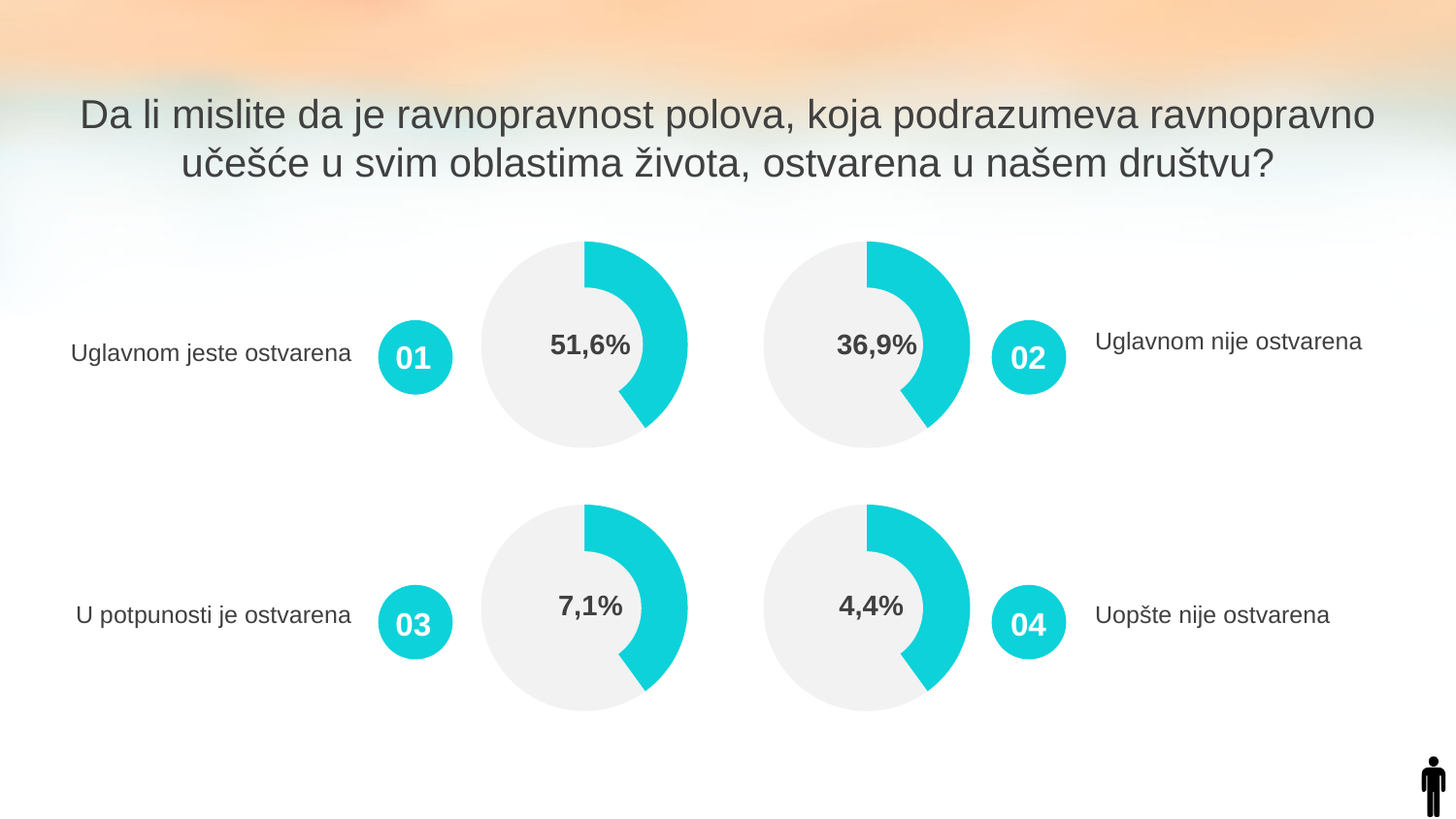
What percentage is shown for "Uglavnom jeste ostvarena"? 51,6% What percentage is shown for "Uglavnom nije ostvarena"? 36,9% Which number label is next to the chart for "Uopšte nije ostvarena"? 04 Which response option has the lowest percentage? Uopšte nije ostvarena What is the difference in percentage points between "Uglavnom jeste ostvarena" and "Uglavnom nije ostvarena"? 14,7 Which response option has the highest percentage? Uglavnom jeste ostvarena How many response options are shown on the slide? 4 What percentage is shown for "Uopšte nije ostvarena"? 4,4% What kind of chart is used to display each percentage on the slide? Donut (pie) chart What percentage is shown for "U potpunosti je ostvarena"? 7,1% What is the difference in percentage points between "U potpunosti je ostvarena" and "Uopšte nije ostvarena"? 2,7 Which is larger, the percentage for "U potpunosti je ostvarena" or for "Uopšte nije ostvarena"? U potpunosti je ostvarena